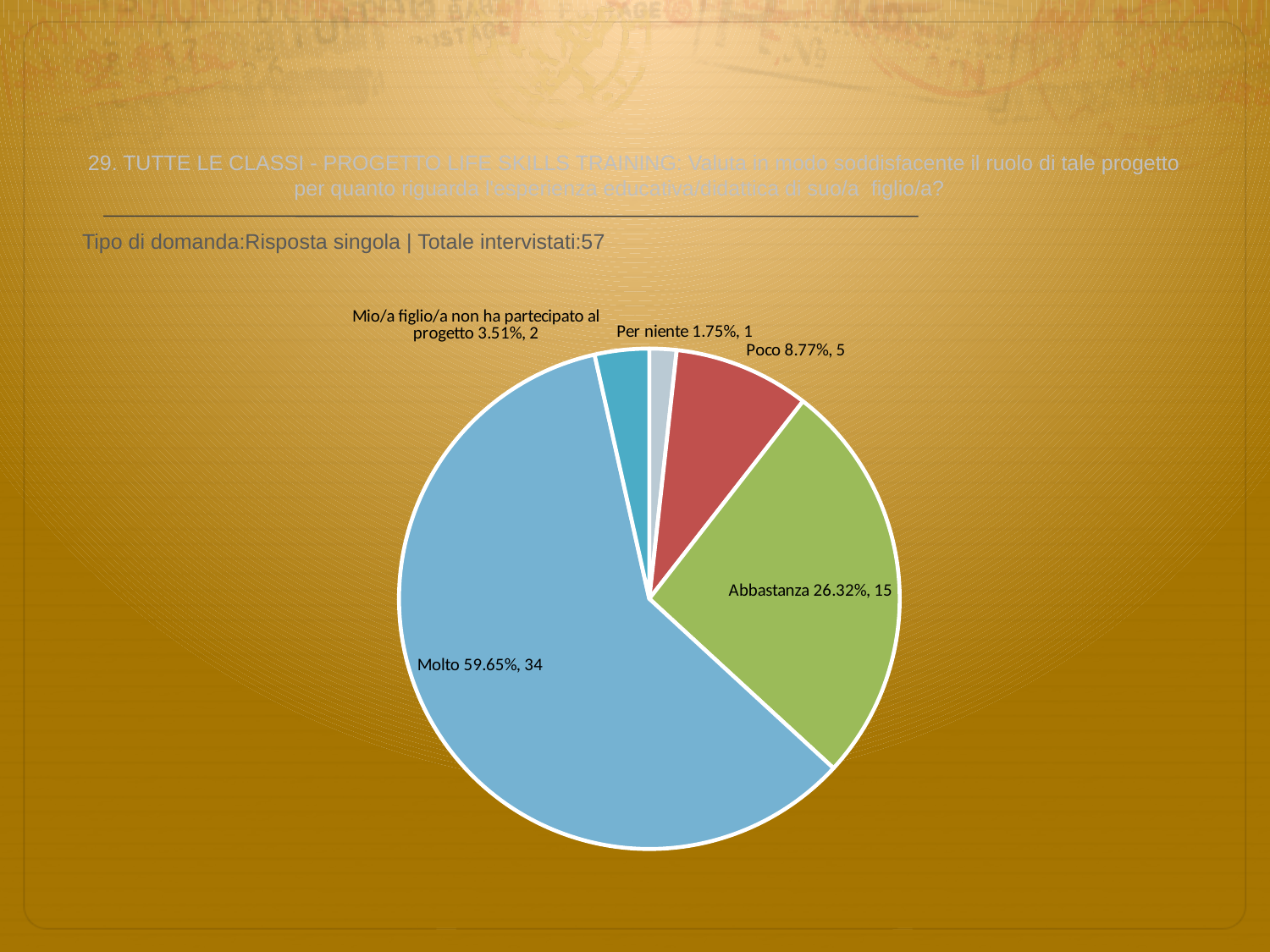
What kind of chart is shown on the slide? pie chart What percentage share does the 'Mio/a figlio/a non ha partecipato al progetto' slice have? 3.51% What is the total number of respondents stated on the slide (Totale intervistati)? 57 How many respondents answered 'Per niente'? 1 Which category has the smallest slice of the pie? Per niente How many slices does the pie chart have? 5 What is the difference in respondent count between 'Molto' and 'Abbastanza'? 19 How many respondents answered 'Abbastanza'? 15 What percentage share does the 'Poco' slice have? 8.77% Which has more respondents, 'Poco' or 'Mio/a figlio/a non ha partecipato al progetto'? Poco What percentage share does the 'Molto' slice have? 59.65% Which category has the largest slice of the pie? Molto